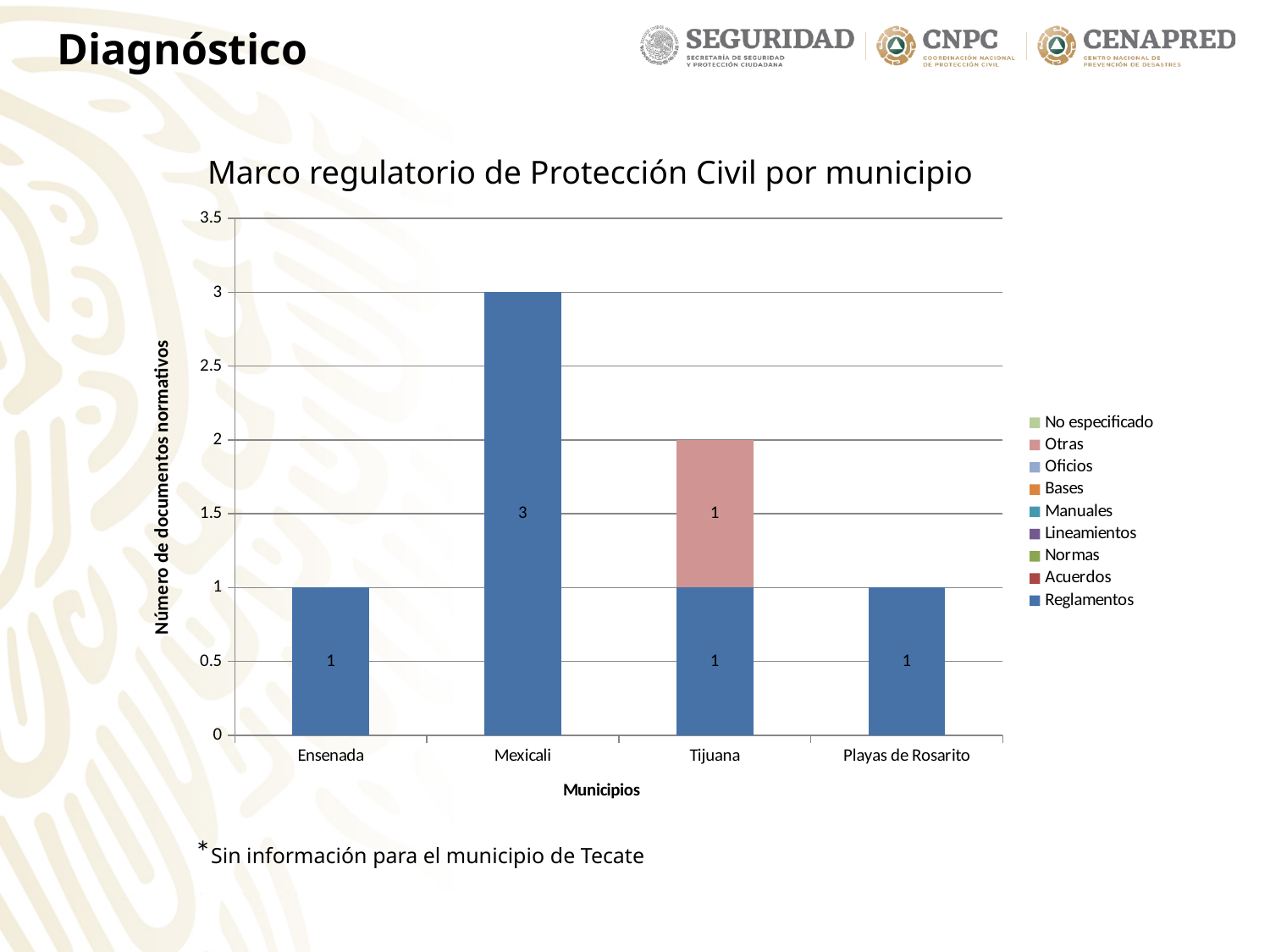
How many municipalities are shown on the x axis? 4 What is the Otras value for Tijuana? 1 How many series does the legend list? 9 What is the total height of the stacked bar for Tijuana? 2 What kind of chart is shown on the slide? Stacked bar chart What is the Reglamentos value for Playas de Rosarito? 1 What is the title of the chart? Marco regulatorio de Protección Civil por municipio What is the Reglamentos value for Mexicali? 3 What is the difference between the Reglamentos values for Mexicali and Ensenada? 2 Which municipality has the highest number of Reglamentos? Mexicali Which is larger, the total bar for Mexicali or the total bar for Tijuana? Mexicali What is the label of the y axis? Número de documentos normativos